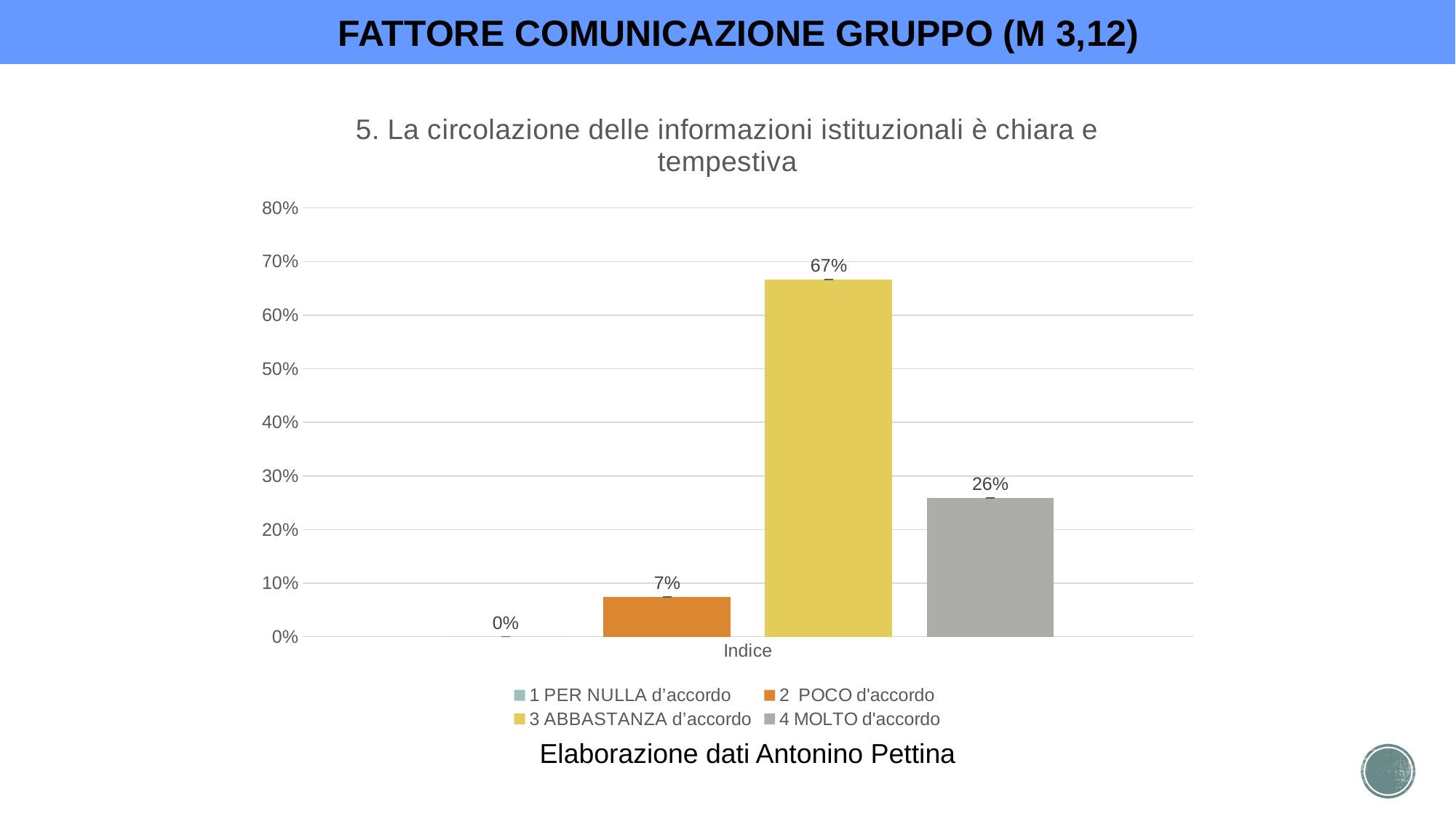
Which is larger, the value for "2 POCO d'accordo" or "4 MOLTO d'accordo"? 4 MOLTO d'accordo What is the value for "4 MOLTO d'accordo"? 26% Which series has the lowest value? 1 PER NULLA d'accordo What kind of chart is shown on the slide? Bar chart Which series has the highest value? 3 ABBASTANZA d'accordo What is the value for "3 ABBASTANZA d'accordo"? 67% What is the label on the x axis under the bars? Indice Is the value for "3 ABBASTANZA d'accordo" greater or less than 60%? greater What is the value for "2 POCO d'accordo"? 7% How many series does the legend list? 4 What is the difference between the values for "3 ABBASTANZA d'accordo" and "4 MOLTO d'accordo"? 41% What is the value for "1 PER NULLA d'accordo"? 0%